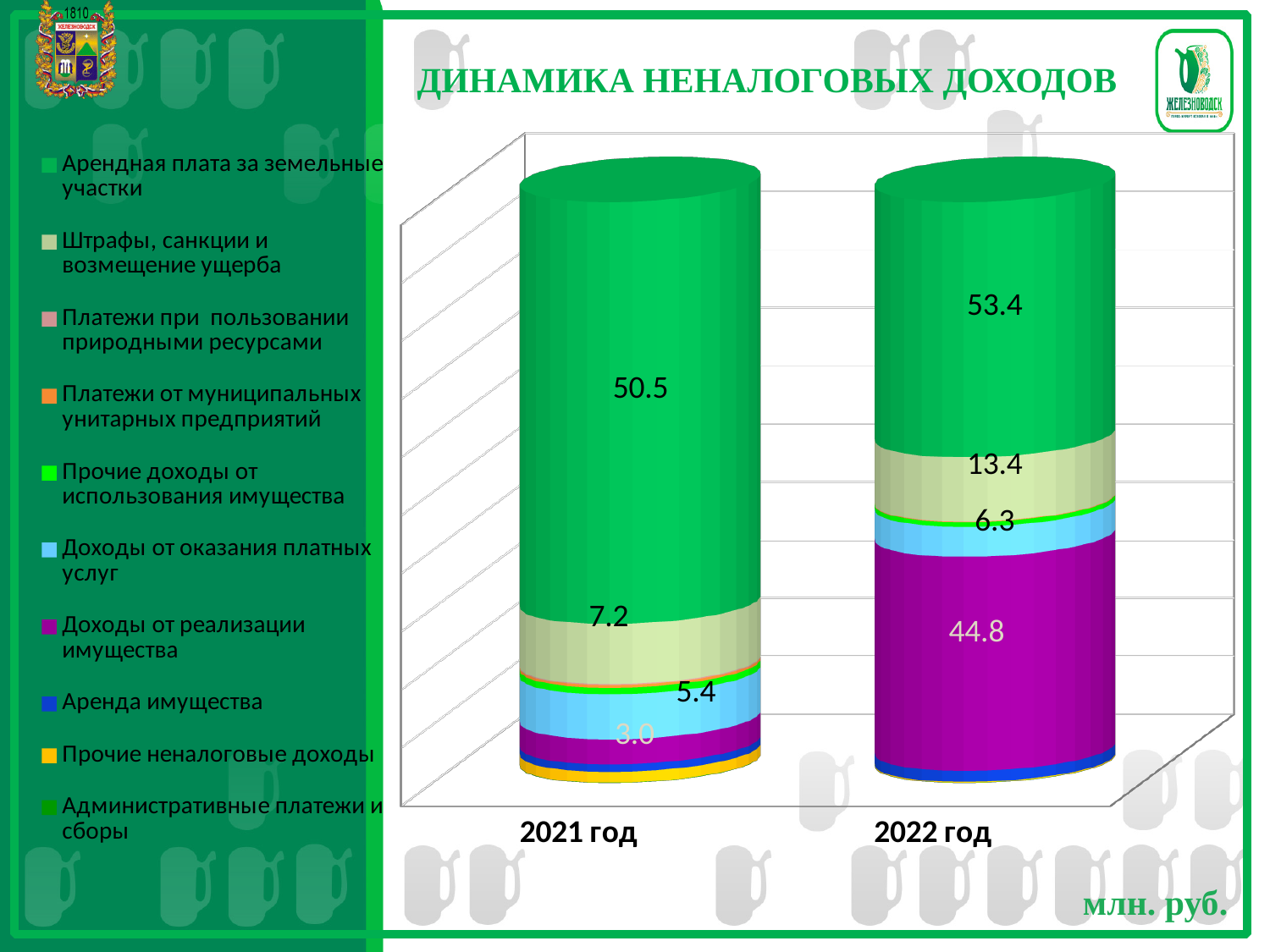
What is the value for Доходы от оказания платных услуг in 2021 год? 5.4 What is the value for Арендная плата за земельные участки in 2021 год? 50.5 What is the difference between the Штрафы, санкции и возмещение ущерба values for 2022 год and 2021 год? 6.2 How many series does the legend list? 10 What is the value for Арендная плата за земельные участки in 2022 год? 53.4 What kind of chart is shown on the slide? Stacked bar chart What is the title of the chart? ДИНАМИКА НЕНАЛОГОВЫХ ДОХОДОВ What is the difference between the Арендная плата за земельные участки values for 2022 год and 2021 год? 2.9 How many categories (years) are shown on the x axis? 2 Which year has the larger value for Доходы от реализации имущества, 2021 год or 2022 год? 2022 год What is the value for Штрафы, санкции и возмещение ущерба in 2022 год? 13.4 What is the value for Доходы от реализации имущества in 2022 год? 44.8